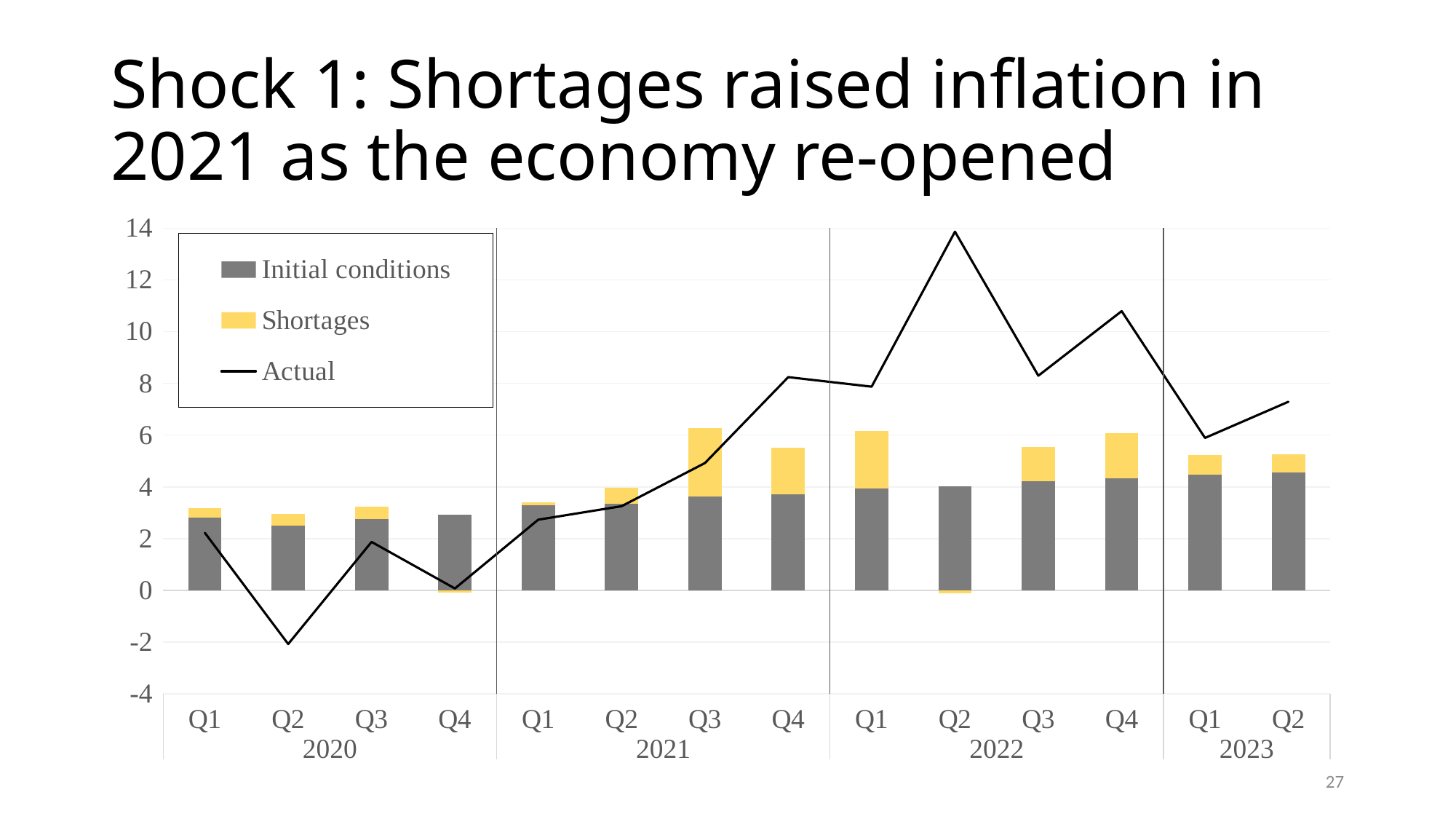
What colour represents Shortages in the legend? Yellow Is the Initial conditions value for Q4 2020 greater or less than 2? greater How many series does the legend list? 3 Which is larger, the Actual value for Q2 2022 or for Q4 2022? Q2 2022 Is the Actual value for Q2 2020 greater or less than 0? less In which quarter does the Actual line reach its highest value? Q2 2022 Is the Actual value for Q2 2022 greater or less than 12? greater In which quarter does the Actual line reach its lowest value? Q2 2020 How many quarters are plotted along the x axis? 14 Does the Actual line rise or fall from Q4 2020 to Q4 2021? rise What kind of chart is shown on the slide? Stacked bar chart with a line